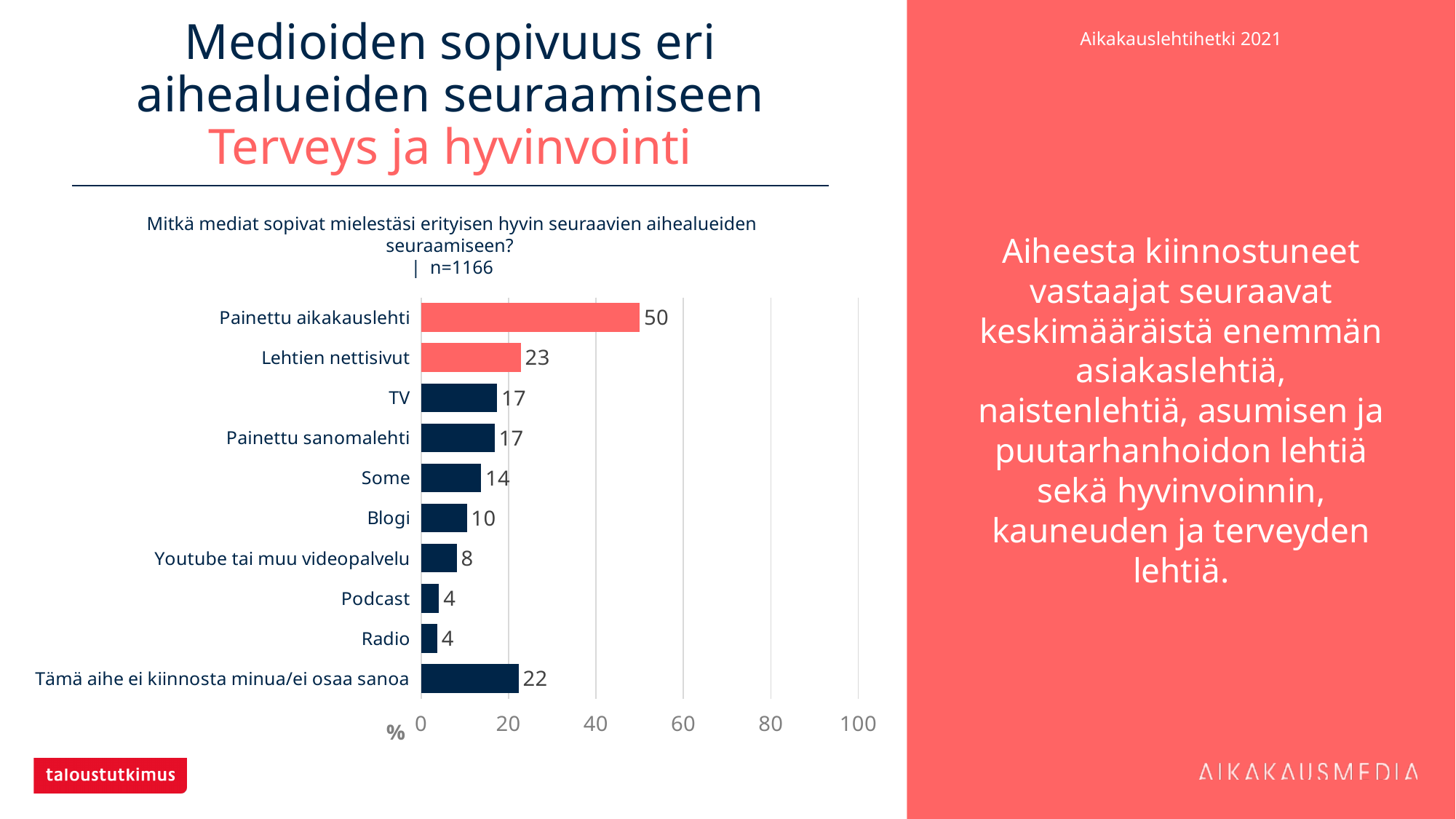
What kind of chart is shown on the slide? bar chart What is the value for Blogi? 10 Which is larger, the value for Some or the value for Youtube tai muu videopalvelu? Some What is the sample size (n) stated above the chart? n=1166 How many categories are shown in the chart? 10 Is the value for Painettu sanomalehti greater or less than 20? less What is the value for Tämä aihe ei kiinnosta minua/ei osaa sanoa? 22 What is the difference between the values for Painettu aikakauslehti and Lehtien nettisivut? 27 What is the value for Painettu aikakauslehti? 50 Which category has the highest value? Painettu aikakauslehti What is the value for Lehtien nettisivut? 23 How many bars are coloured red/pink rather than dark blue? 2